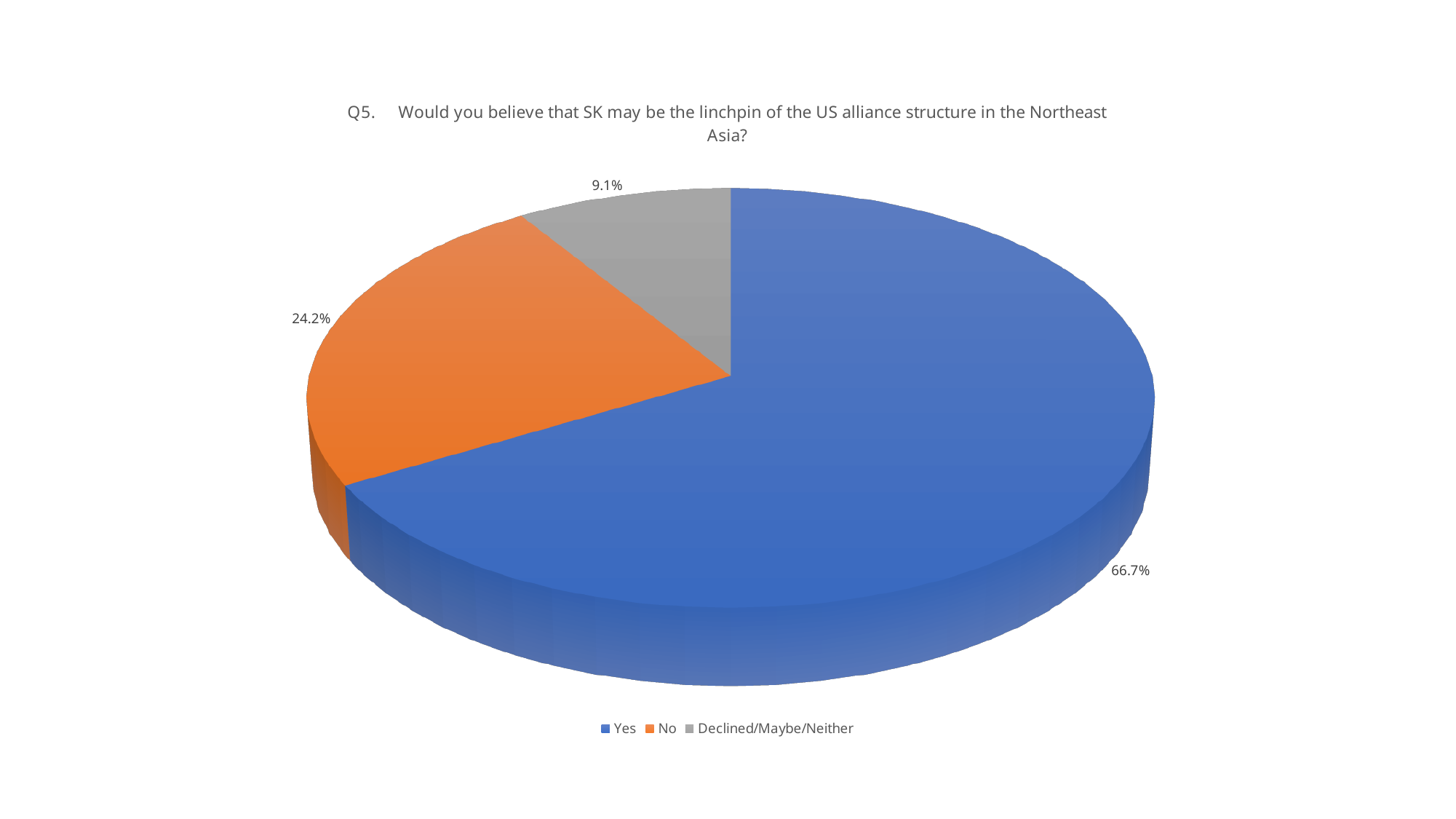
What kind of chart is shown on the slide? Pie chart Which is larger, the share for "No" or the share for "Declined/Maybe/Neither"? No What percentage of respondents answered "No"? 24.2% Which response category has the largest share of the pie? Yes What is the difference in percentage points between the "Yes" and "No" shares? 42.5 What percentage of respondents fall under "Declined/Maybe/Neither"? 9.1% How many categories does the pie chart have? 3 Which response category has the smallest share of the pie? Declined/Maybe/Neither What question number is shown in the chart title? Q5 What percentage of respondents answered "Yes"? 66.7% What colour is the slice representing "No"? Orange What is the difference in percentage points between the "No" and "Declined/Maybe/Neither" shares? 15.1